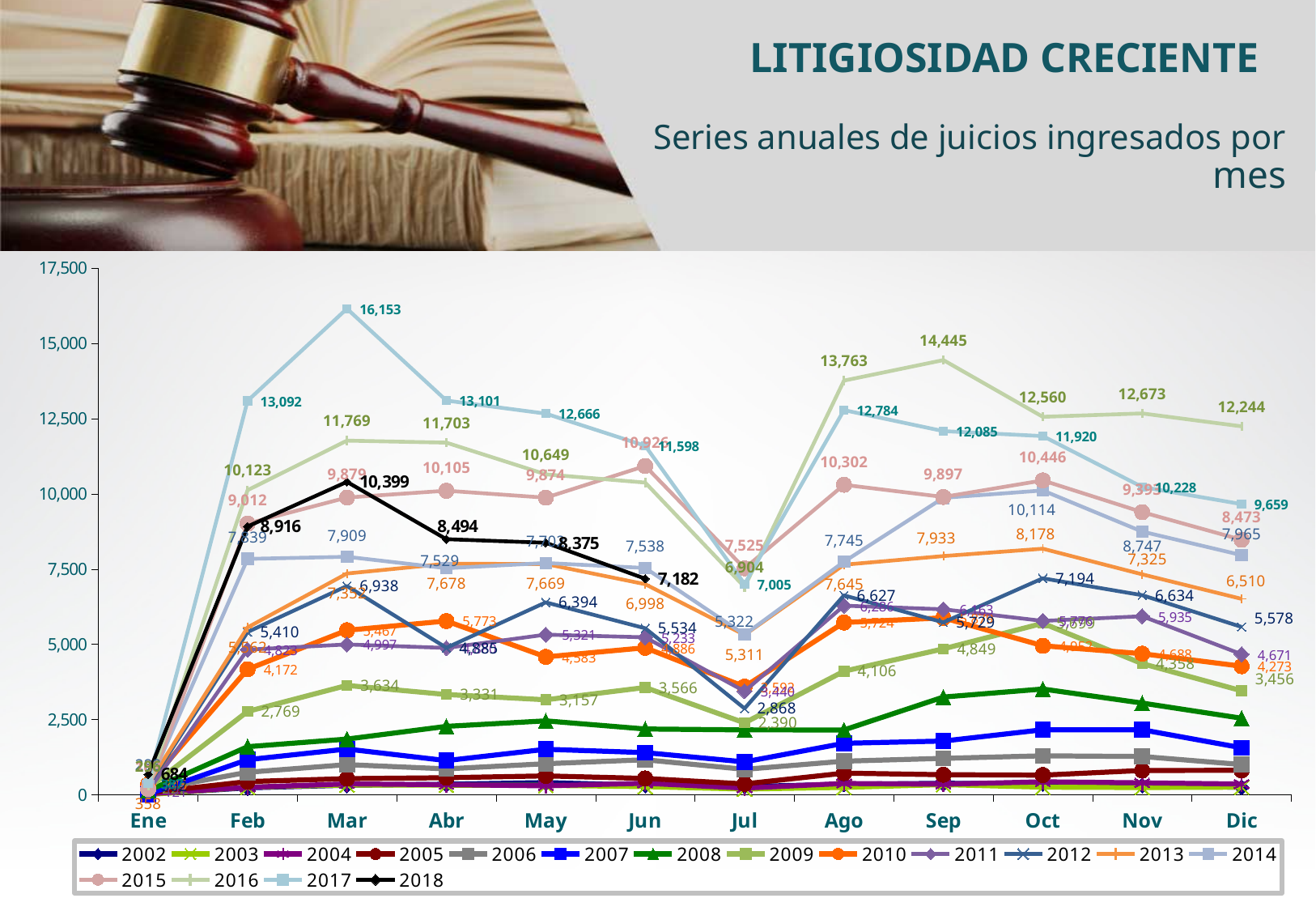
Which series has the larger value in Sep, 2016 or 2017? 2016 What is the value for 2018 in Jun? 7,182 What is the value for 2016 in Sep? 14,445 How many series does the legend list? 17 Does the 2018 series rise or fall from Mar to Jun? fall In which month does the 2017 series reach its highest value? Mar How many months are shown along the x axis? 12 What kind of chart is shown on the slide? line chart What is the value for 2017 in Mar? 16,153 What is the difference between the 2017 values for Mar and Feb? 3,061 What is the value for 2018 in Mar? 10,399 Is the value for 2008 in Oct greater or less than 5,000? less